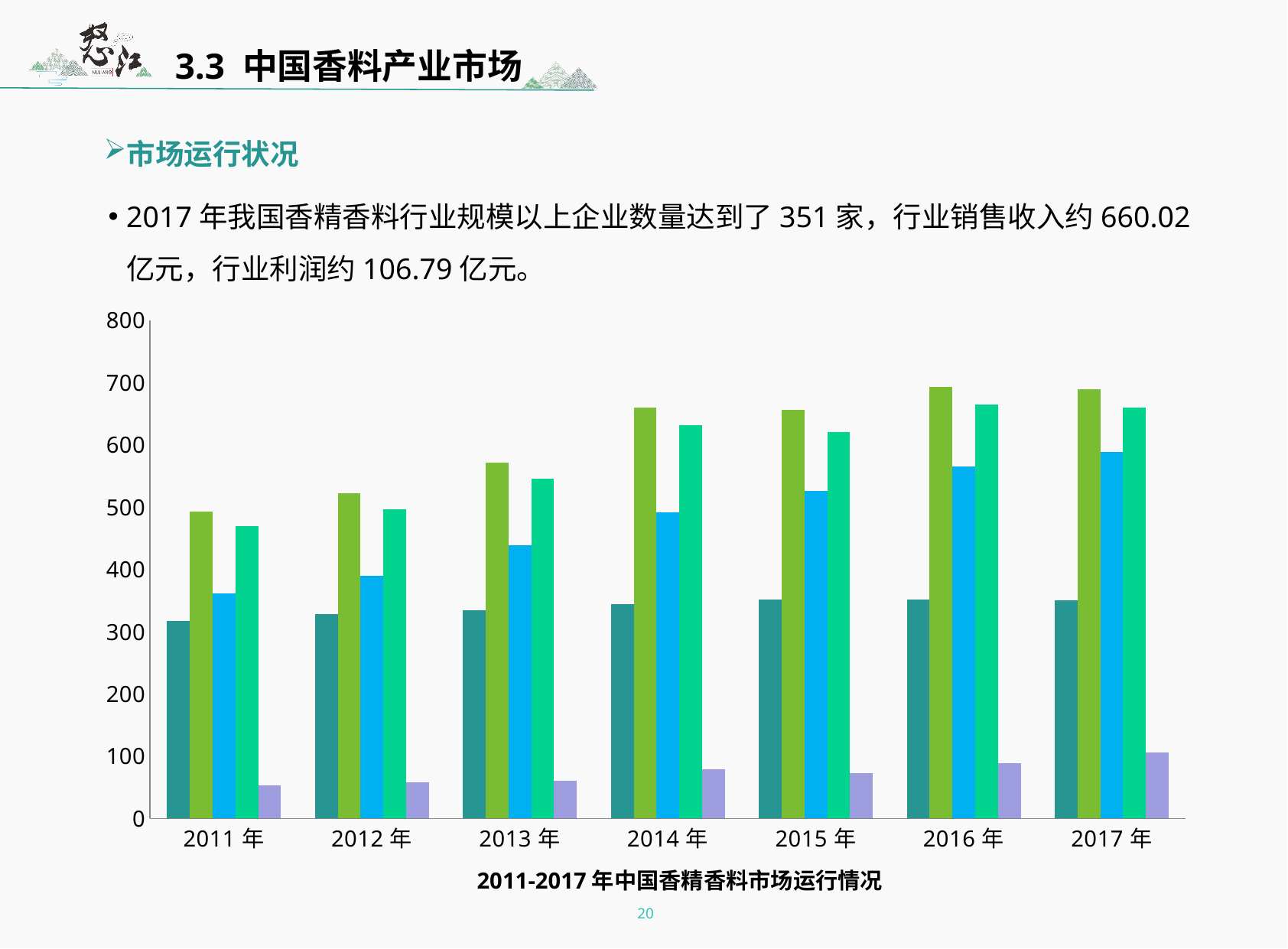
How many bars are plotted for each year in the chart? 5 Is the value of the blue bar for 2011 年 greater or less than 400? less Is the value of the dark teal (first) bar for 2017 年 greater or less than 400? less Is the value of the green (second) bar for 2016 年 greater or less than 600? greater In which year is the blue bar the tallest? 2017 年 Which is larger: the green (second) bar for 2013 年 or the green (second) bar for 2014 年? 2014 年 What kind of chart is shown on the slide? bar chart How many years (categories) are shown on the x axis of the chart? 7 In which year is the blue bar the shortest? 2011 年 Do the blue bars rise or fall from 2011 年 to 2017 年? rise What is the title of the chart? 2011-2017 年中国香精香料市场运行情况